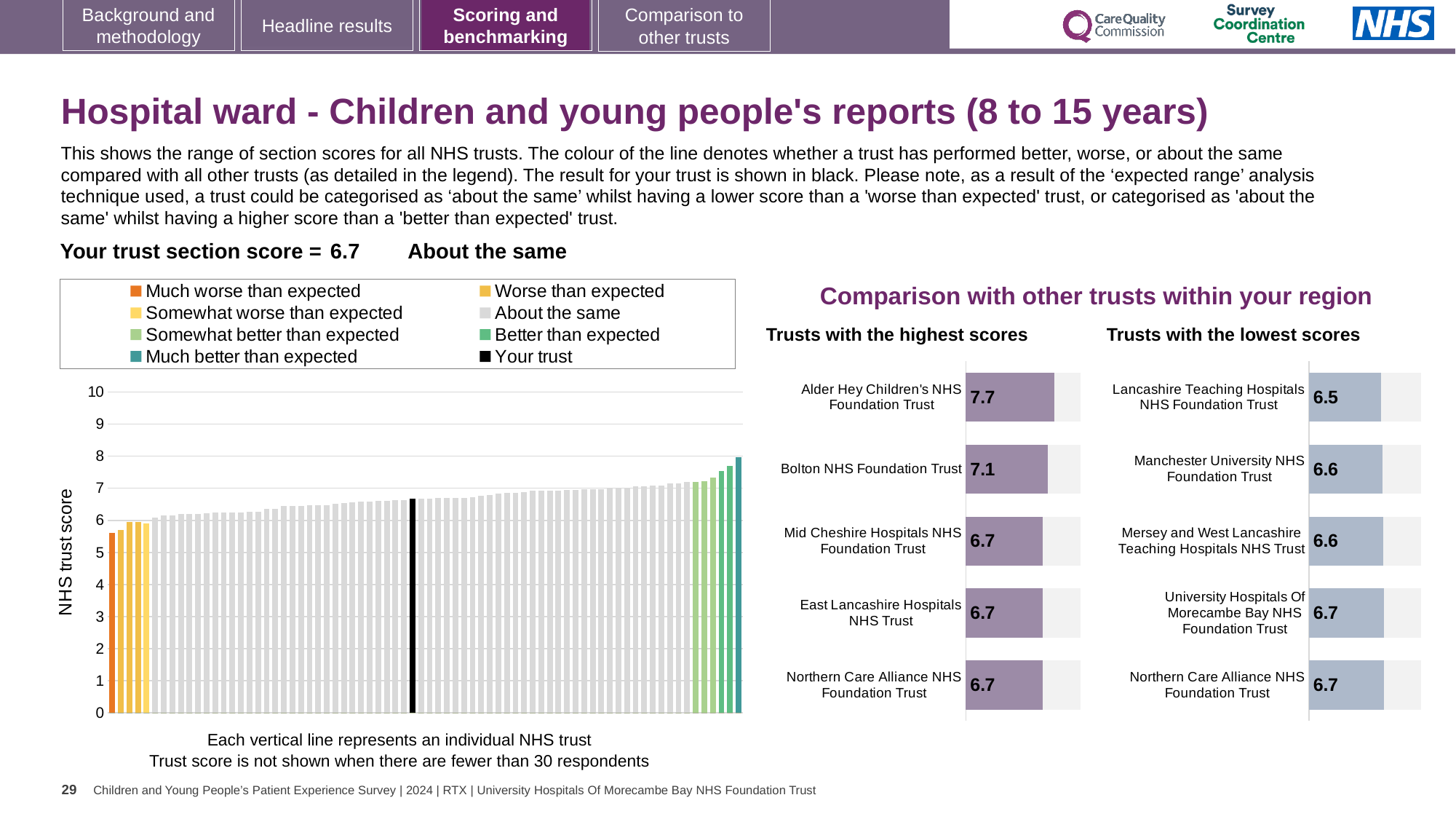
How many trusts are shown in the 'Trusts with the highest scores' chart? 5 In the 'Trusts with the highest scores' chart, which trust has the highest score? Alder Hey Children's NHS Foundation Trust In the 'Trusts with the lowest scores' chart, what is the score for University Hospitals Of Morecambe Bay NHS Foundation Trust? 6.7 In the 'Trusts with the highest scores' chart, what is the difference between the scores of Alder Hey Children's NHS Foundation Trust and Bolton NHS Foundation Trust? 0.6 In the 'Trusts with the lowest scores' chart, what is the score for Lancashire Teaching Hospitals NHS Foundation Trust? 6.5 In the 'Trusts with the highest scores' chart, what is the score for Bolton NHS Foundation Trust? 7.1 In the 'Trusts with the lowest scores' chart, what is the difference between the scores of University Hospitals Of Morecambe Bay NHS Foundation Trust and Lancashire Teaching Hospitals NHS Foundation Trust? 0.2 What kind of chart is the large chart on the left with the y-axis labelled 'NHS trust score'? Bar chart In the large chart on the left with the y-axis labelled 'NHS trust score', do the bar values rise or fall from left to right? Rise In the 'Trusts with the highest scores' chart, what is the score for Alder Hey Children's NHS Foundation Trust? 7.7 In the 'Trusts with the lowest scores' chart, which is larger: the score for Manchester University NHS Foundation Trust or the score for Lancashire Teaching Hospitals NHS Foundation Trust? Manchester University NHS Foundation Trust In the 'Trusts with the lowest scores' chart, which trust has the lowest score? Lancashire Teaching Hospitals NHS Foundation Trust